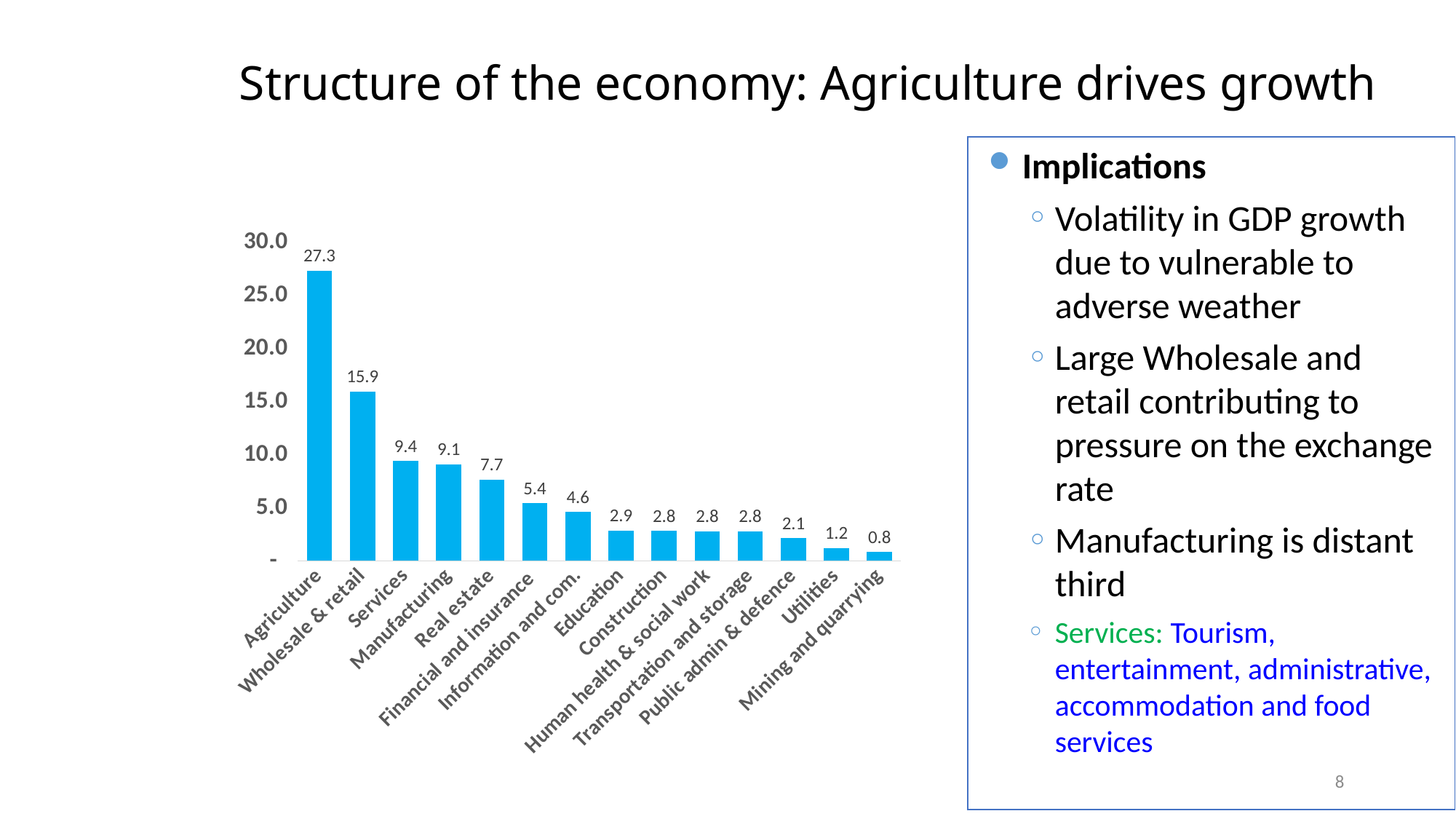
Do the values rise or fall from left to right along the x axis? Fall What is the value for Mining and quarrying? 0.8 What is the value for Agriculture? 27.3 How many categories are shown on the chart? 14 What is the value for Manufacturing? 9.1 What is the value for Wholesale & retail? 15.9 Which category has the lowest value? Mining and quarrying Which is larger, the value for Real estate or the value for Financial and insurance? Real estate What is the difference between the values for Agriculture and Wholesale & retail? 11.4 What kind of chart is shown on the slide? Bar chart Which category has the highest value? Agriculture Is the value for Services greater or less than 10.0? less